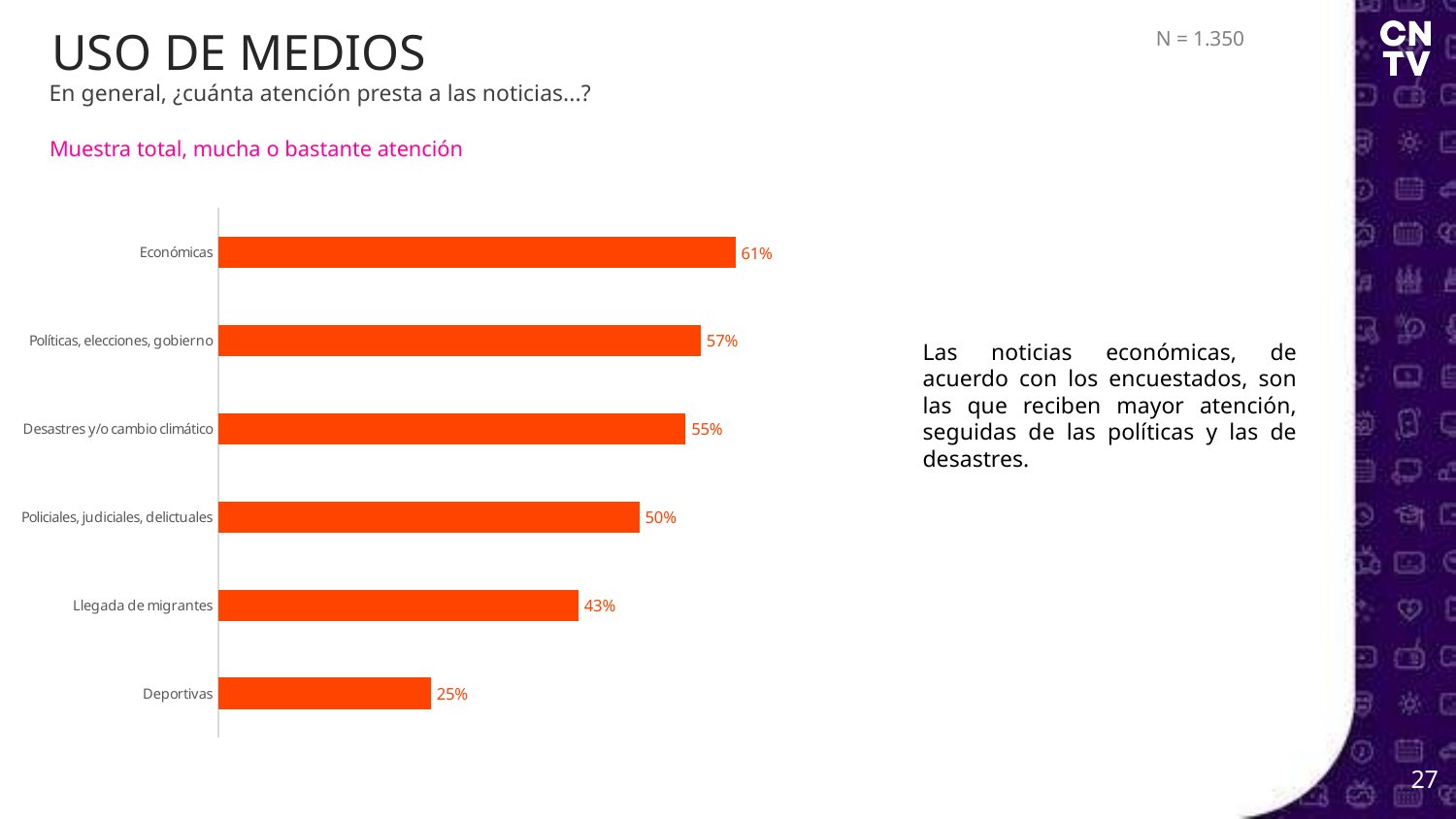
What is the sample size (N) indicated on the slide? 1.350 What colour are the bars in the chart? Orange What type of chart is shown on the slide? Bar chart Which news category has the highest percentage in the chart? Económicas Which news category has the lowest percentage in the chart? Deportivas What is the value shown for 'Llegada de migrantes'? 43% What is the difference in percentage points between 'Económicas' and 'Deportivas'? 36 What percentage of respondents pay much or quite a lot of attention to economic news (Económicas)? 61% What is the difference in percentage points between 'Políticas, elecciones, gobierno' and 'Desastres y/o cambio climático'? 2 What is the value shown for 'Policiales, judiciales, delictuales'? 50% Which has a higher value: 'Desastres y/o cambio climático' or 'Llegada de migrantes'? Desastres y/o cambio climático How many news categories are shown in the chart? 6